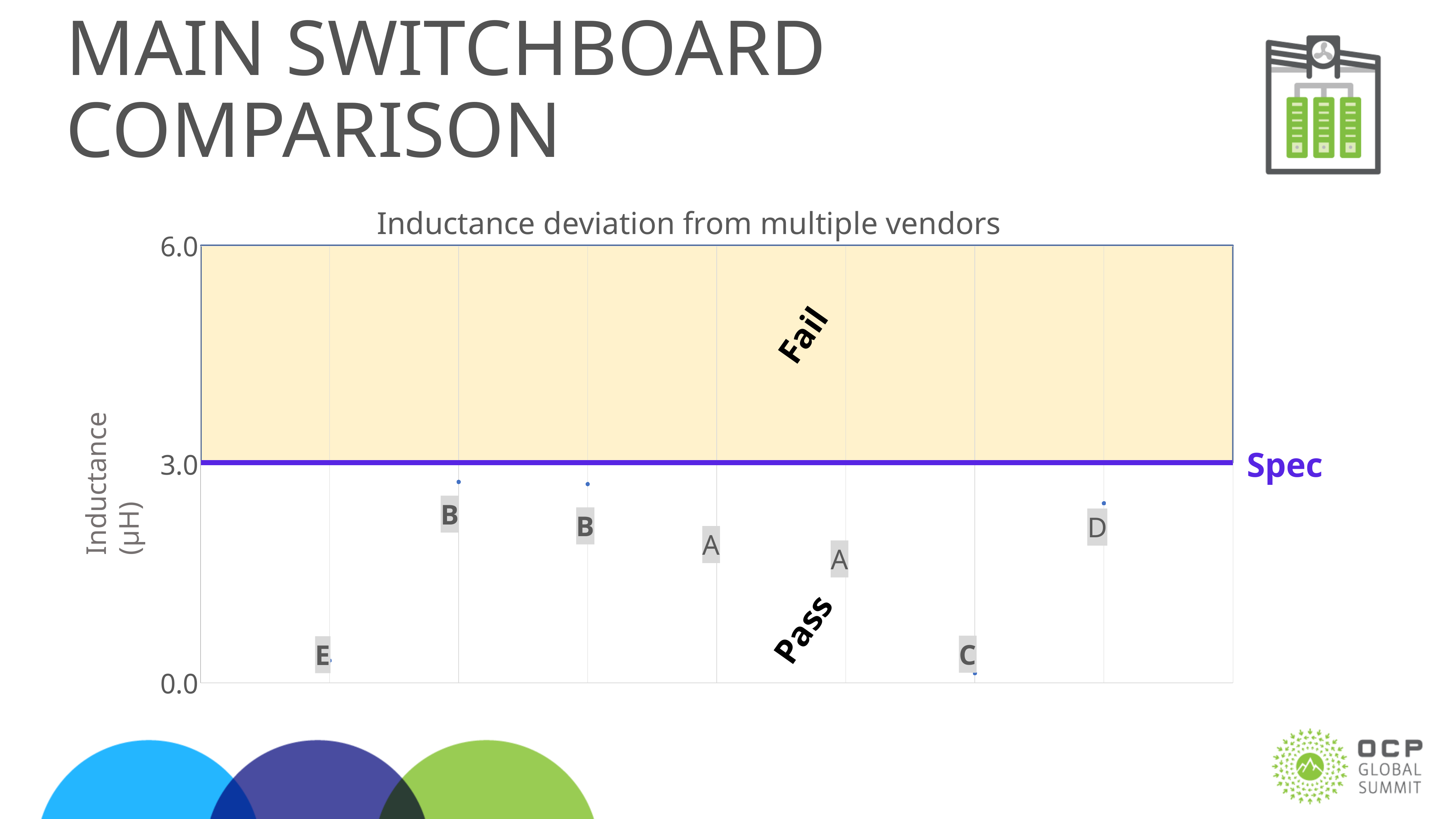
Which is larger, the value for vendor D or the value for vendor E? D Is the value for vendor D greater or less than 3.0? less What kind of chart is shown on the slide? scatter chart At what inductance value is the Spec line drawn? 3.0 What is the maximum value shown on the y axis? 6.0 Which region of the chart is shaded, the Fail region or the Pass region? Fail Is the value for vendor C greater or less than 3.0? less Is the value for vendor E greater or less than 3.0? less Which is larger, the value for vendor B or the value for vendor C? B What is the label of the y axis? Inductance (µH) How many labelled data points are plotted on the chart? 7 What is the title of the chart? Inductance deviation from multiple vendors